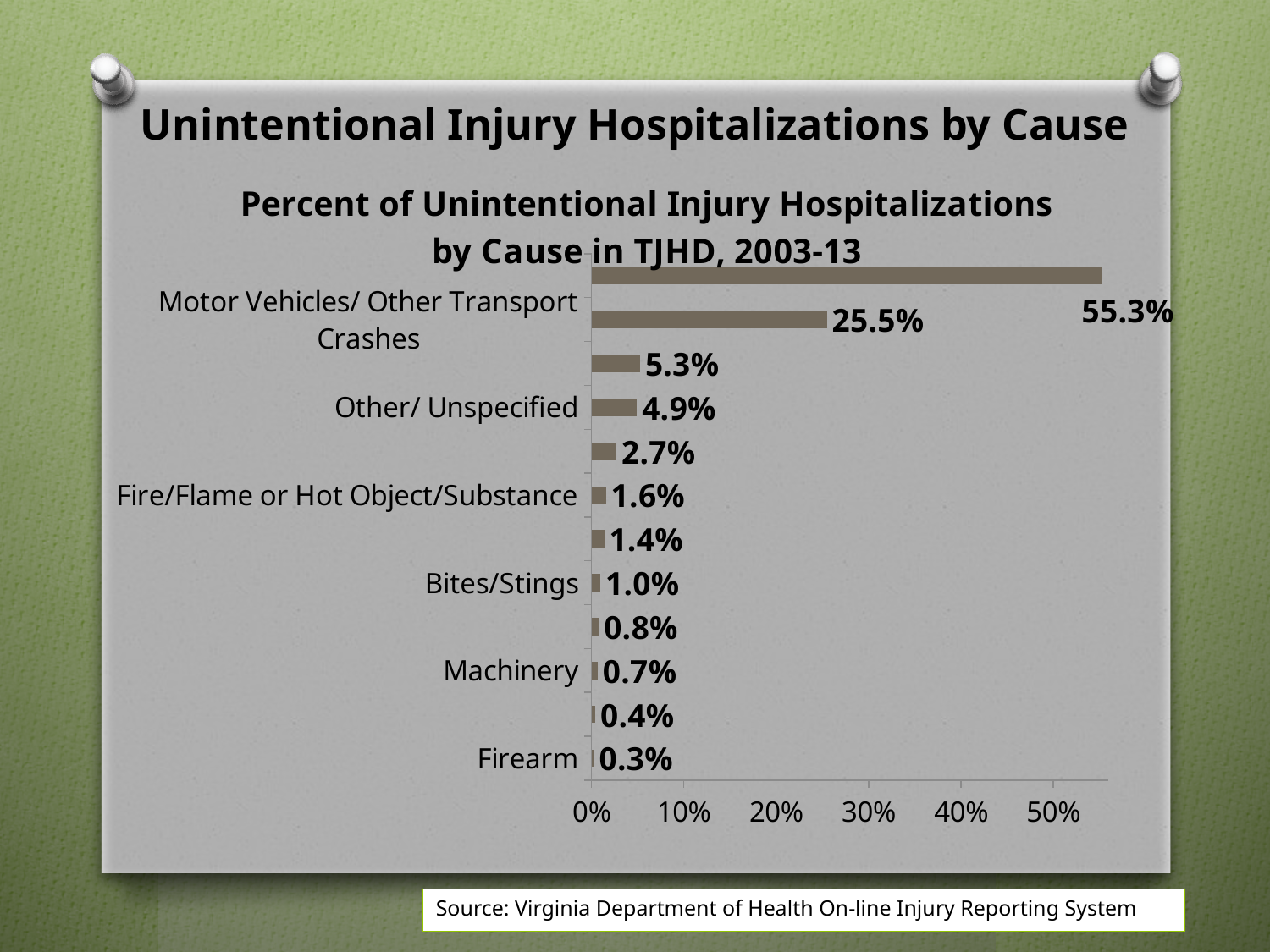
What type of chart is shown on the slide? bar chart What is the largest value shown on the chart? 55.3% What is the value for Other/ Unspecified? 4.9% Which is larger, the value for Bites/Stings or the value for Machinery? Bites/Stings What is the value for Machinery? 0.7% What is the value for Fire/Flame or Hot Object/Substance? 1.6% What is the value for Bites/Stings? 1.0% What is the title of the chart? Percent of Unintentional Injury Hospitalizations by Cause in TJHD, 2003-13 Which labeled cause has the lowest percentage? Firearm What is the difference between the values for Motor Vehicles/ Other Transport Crashes and Other/ Unspecified? 20.6% What percent of unintentional injury hospitalizations is attributed to Motor Vehicles/ Other Transport Crashes? 25.5% How many bars are plotted in the chart? 12